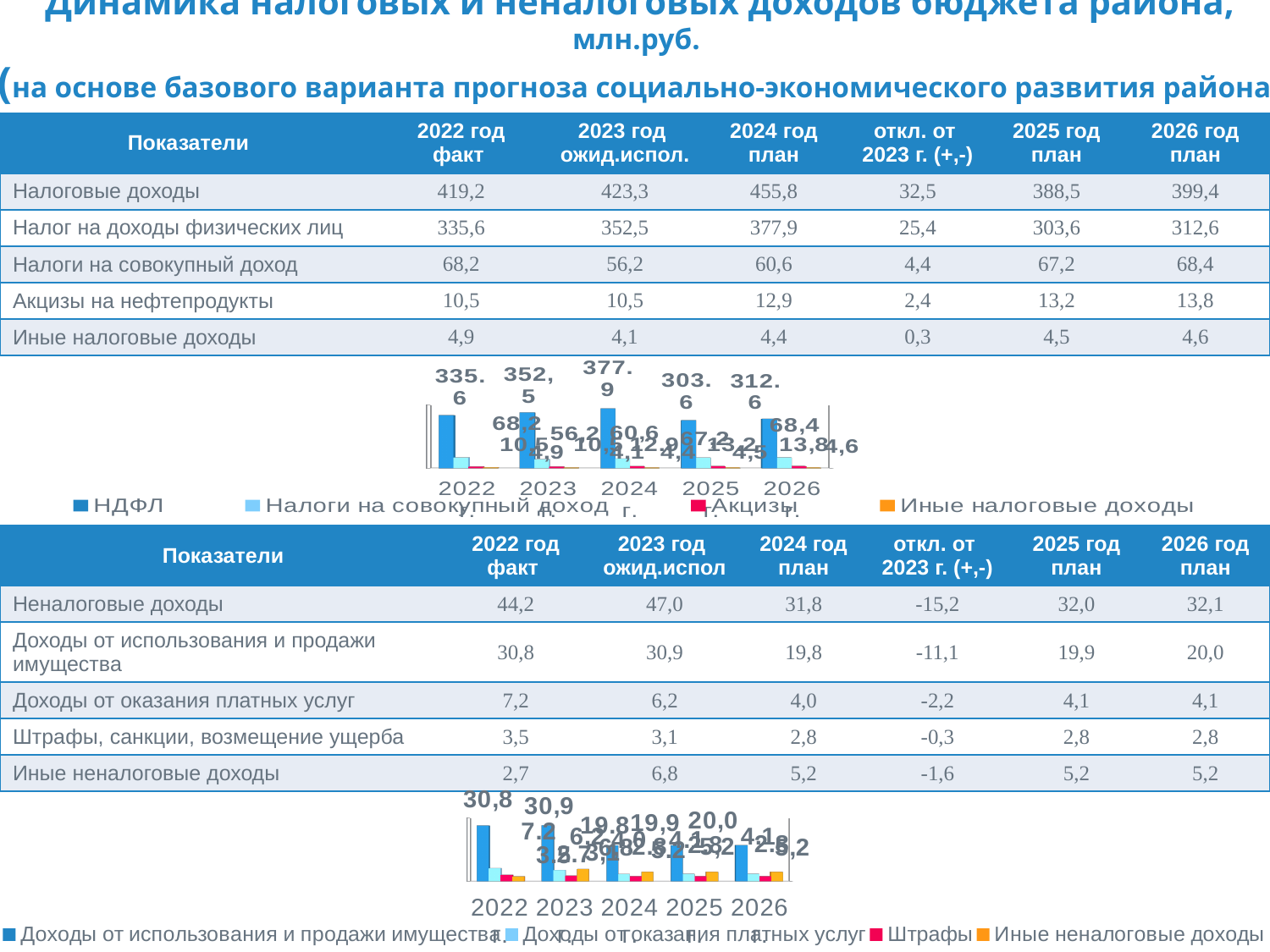
What kind of chart is the upper chart (below the tax revenues table)? bar chart What kind of chart is the lower chart (below the non-tax revenues table)? bar chart How many series does the legend of the upper chart list? 4 In the upper chart, which is larger in 2023: НДФЛ or Налоги на совокупный доход? НДФЛ How many years are shown on the x axis of the upper chart? 5 In the upper chart, which year has the highest value for НДФЛ? 2024 In the upper chart, what is the value for Налоги на совокупный доход in 2022? 68,2 In the lower chart, what is the value for Доходы от использования и продажи имущества in 2022? 30,8 In the lower chart, which series is shown in dark blue according to the legend? Доходы от использования и продажи имущества How many series does the legend of the lower chart list? 4 In the upper chart, what is the value for Налоги на совокупный доход in 2026? 68,4 In the lower chart, what is the value for Доходы от использования и продажи имущества in 2026? 20,0